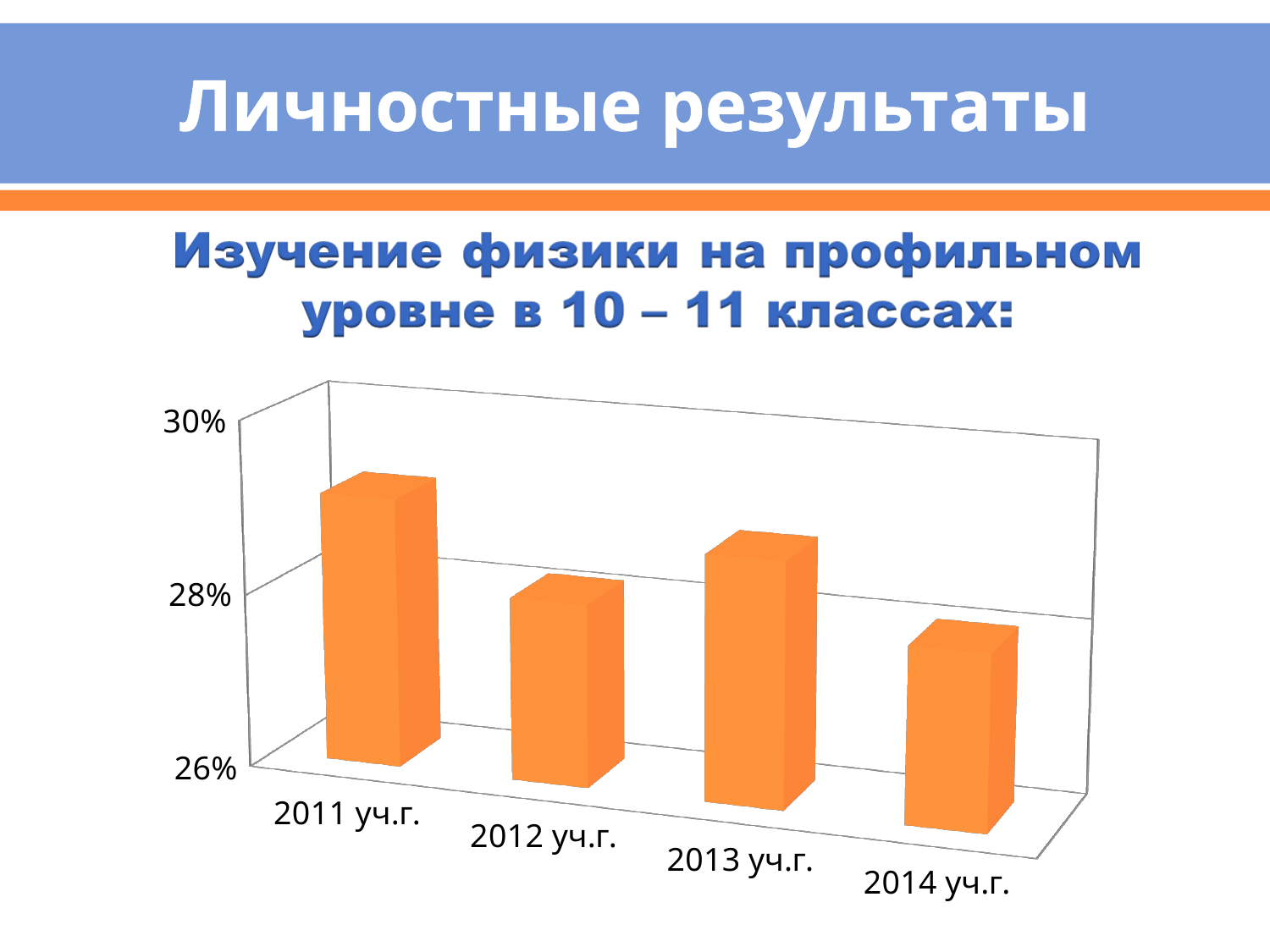
What is the title of the chart? Изучение физики на профильном уровне в 10 – 11 классах: Is the value for 2012 уч.г. greater or less than 30%? less What kind of chart is shown on the slide? bar chart Is the value for 2014 уч.г. greater or less than 30%? less Which is larger, the value for 2011 уч.г. or for 2012 уч.г.? 2011 уч.г. How many academic years are shown on the x axis of the chart? 4 Is the value for 2011 уч.г. greater or less than 28%? greater Does the value rise or fall from 2011 уч.г. to 2012 уч.г.? fall Which is larger, the value for 2013 уч.г. or for 2012 уч.г.? 2013 уч.г. Which academic year has the highest value in the chart? 2011 уч.г. What colour are the bars in the chart? orange